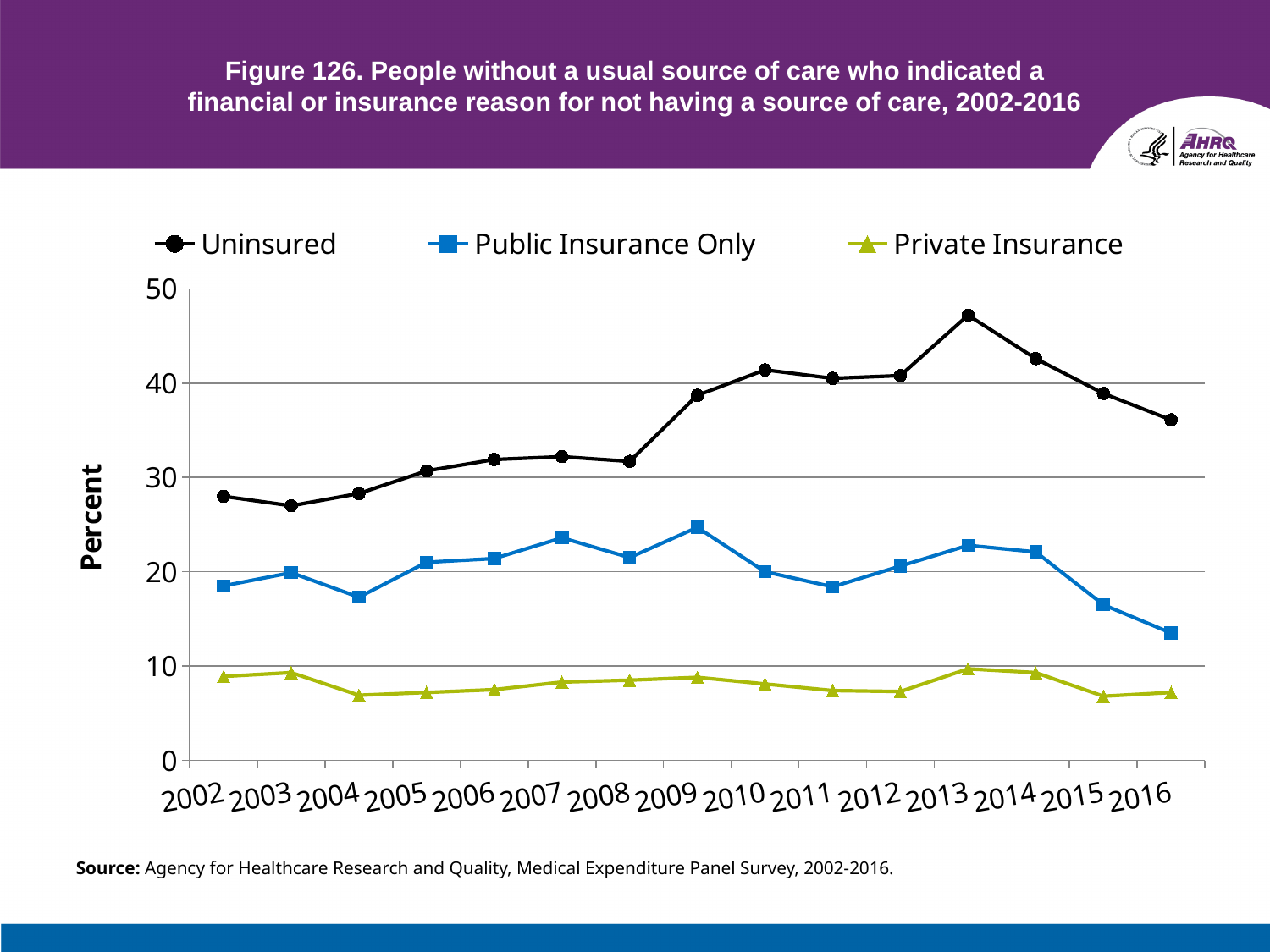
In which year is the Uninsured series at its highest? 2013 Is the value for Uninsured in 2013 greater or less than 40? greater Which series has the higher value in 2010, Uninsured or Public Insurance Only? Uninsured What kind of chart is shown on the slide? line chart How many series does the legend list? 3 Does the Public Insurance Only series rise or fall from 2014 to 2016? fall Is the value for Public Insurance Only in 2016 greater or less than 20? less What is the label on the y axis? Percent How many years are plotted along the x axis? 15 Does the Uninsured series rise or fall from 2013 to 2016? fall Is the value for Uninsured in 2002 greater or less than 30? less In which year is the Public Insurance Only series at its lowest? 2016